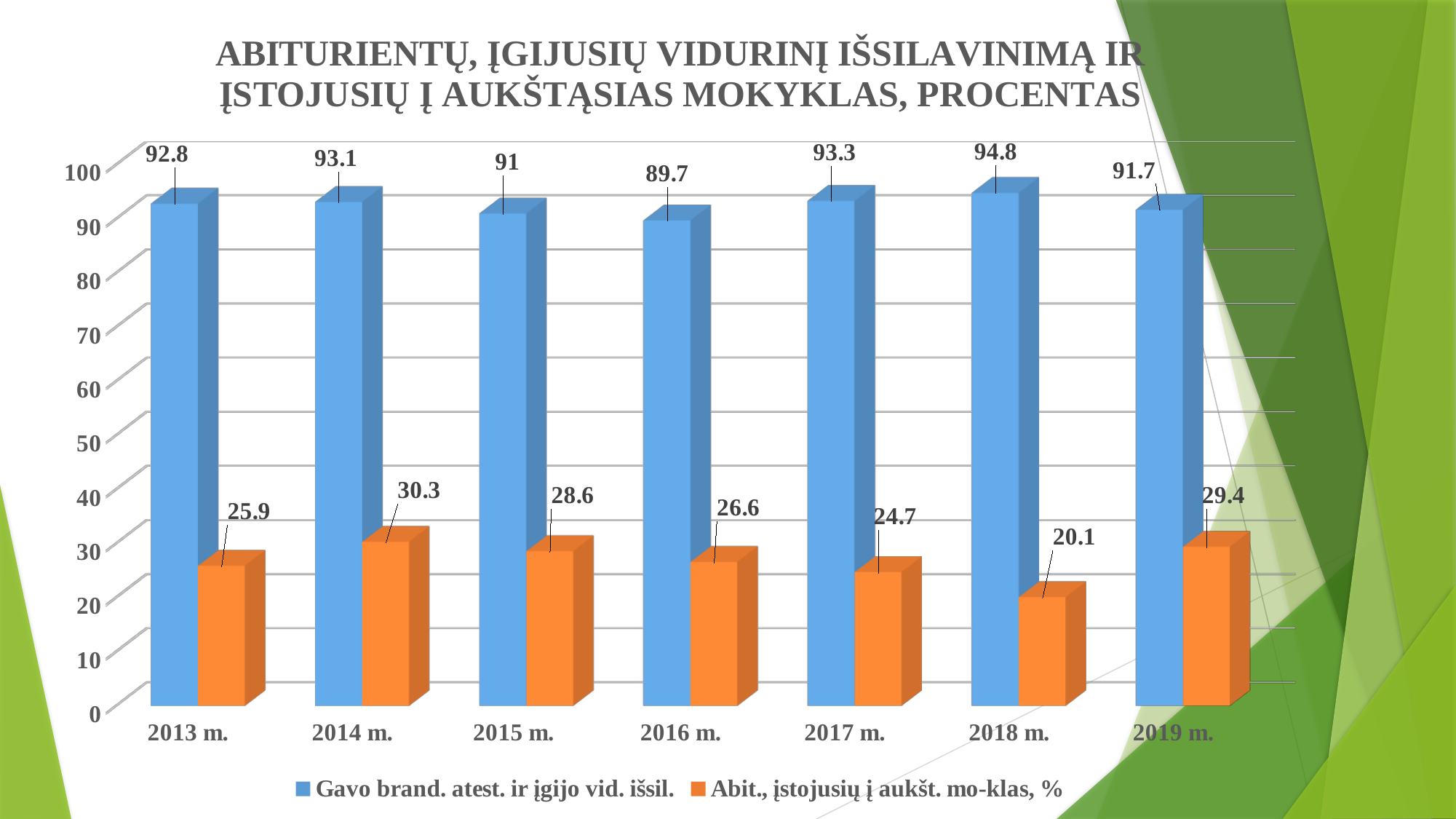
What kind of chart is shown on the slide? bar chart Which year has a larger 'Abit., įstojusių į aukšt. mo-klas, %' value, 2015 m. or 2017 m.? 2015 m. Is the 'Abit., įstojusių į aukšt. mo-klas, %' value for 2018 m. greater or less than 30? less How many series does the legend list? 2 In which year is the 'Gavo brand. atest. ir įgijo vid. išsil.' value the lowest? 2016 m. What is the value for 'Gavo brand. atest. ir įgijo vid. išsil.' in 2018 m.? 94.8 In which year is the 'Abit., įstojusių į aukšt. mo-klas, %' value the highest? 2014 m. How many years are shown on the x axis? 7 What is the value for 'Abit., įstojusių į aukšt. mo-klas, %' in 2014 m.? 30.3 What is the difference between the 'Gavo brand. atest. ir įgijo vid. išsil.' values for 2018 m. and 2016 m.? 5.1 In which year is the 'Abit., įstojusių į aukšt. mo-klas, %' value the lowest? 2018 m. What is the value for 'Abit., įstojusių į aukšt. mo-klas, %' in 2019 m.? 29.4